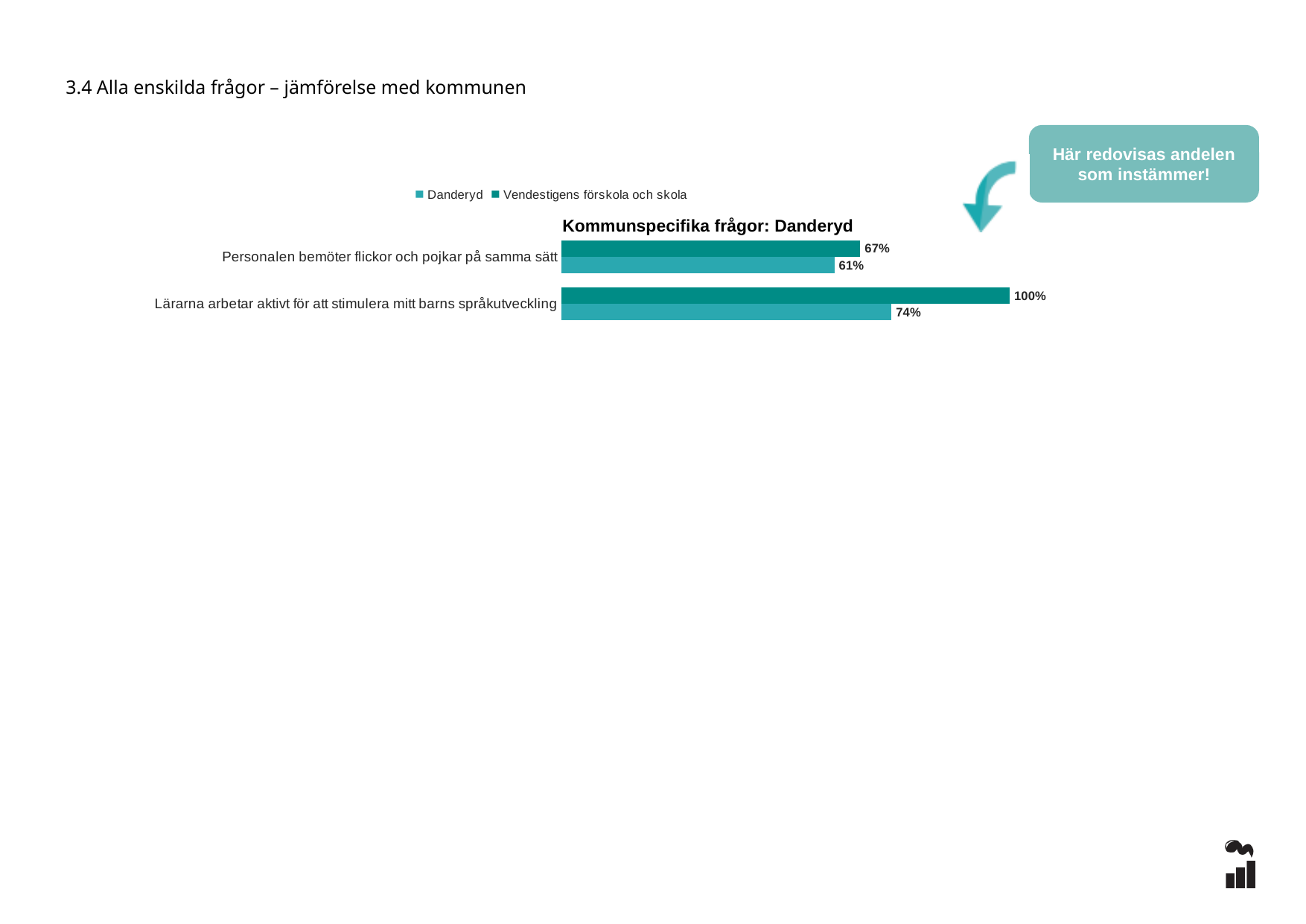
What is the value for Vendestigens förskola och skola for 'Personalen bemöter flickor och pojkar på samma sätt'? 67% What is the title of the chart? Kommunspecifika frågor: Danderyd What is the value for Danderyd for 'Lärarna arbetar aktivt för att stimulera mitt barns språkutveckling'? 74% What is the difference between Vendestigens förskola och skola and Danderyd for 'Personalen bemöter flickor och pojkar på samma sätt'? 6 percentage points What is the difference between Vendestigens förskola och skola and Danderyd for 'Lärarna arbetar aktivt för att stimulera mitt barns språkutveckling'? 26 percentage points How many categories (questions) are shown in the chart? 2 How many series does the legend list? 2 What is the value for Vendestigens förskola och skola for 'Lärarna arbetar aktivt för att stimulera mitt barns språkutveckling'? 100% What type of chart is shown on the slide? Bar chart Which series has the higher value for 'Personalen bemöter flickor och pojkar på samma sätt'? Vendestigens förskola och skola Which bar in the chart has the highest value? Vendestigens förskola och skola for 'Lärarna arbetar aktivt för att stimulera mitt barns språkutveckling' (100%) What is the value for Danderyd for 'Personalen bemöter flickor och pojkar på samma sätt'? 61%